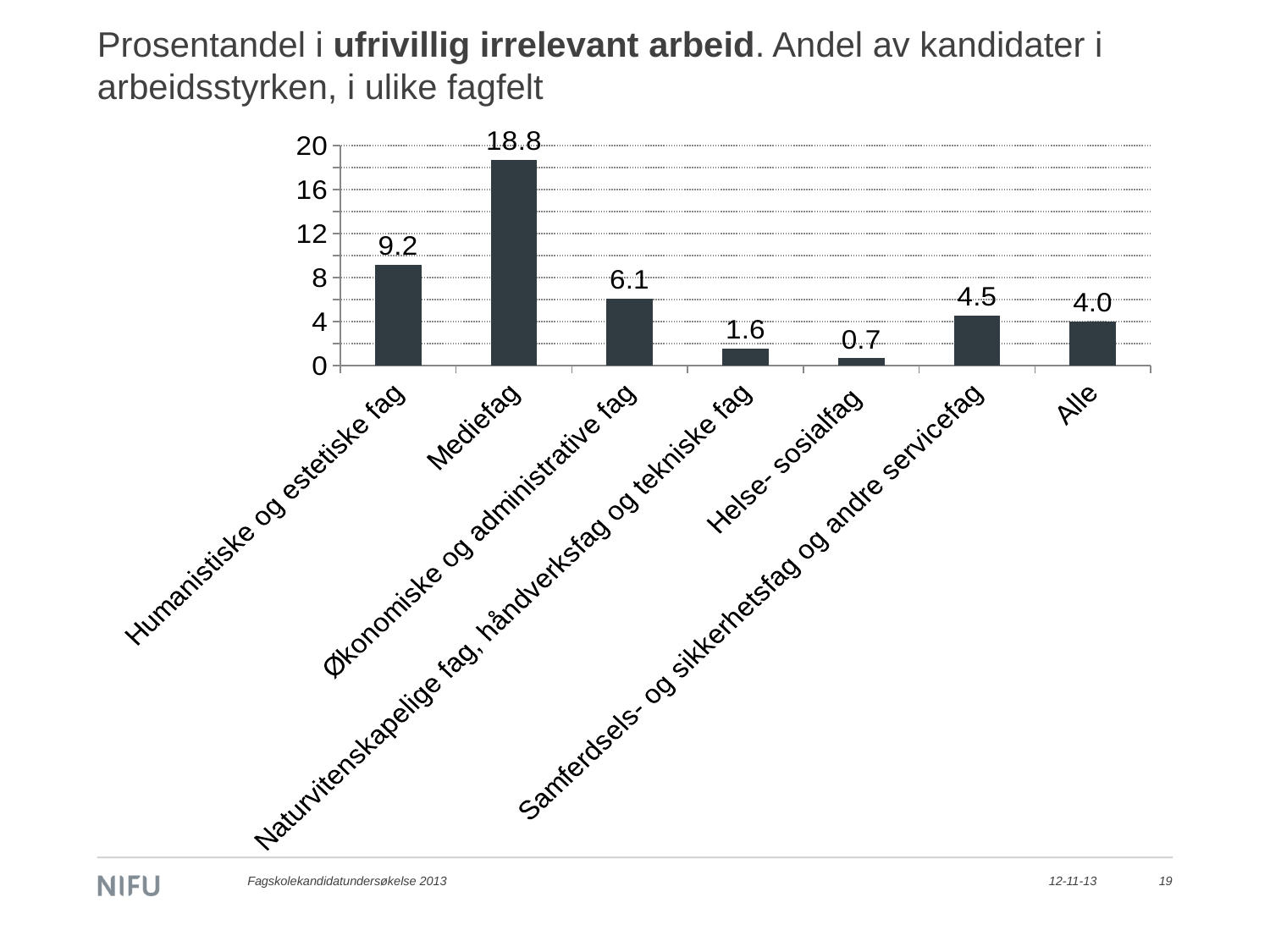
What is the value for Humanistiske og estetiske fag? 9.2 Which category has the lowest value? Helse- sosialfag What is the difference between the values for Samferdsels- og sikkerhetsfag og andre servicefag and Alle? 0.5 Which is larger, the value for Økonomiske og administrative fag or the value for Samferdsels- og sikkerhetsfag og andre servicefag? Økonomiske og administrative fag What is the value for Mediefag? 18.8 How many categories are shown on the x axis? 7 Which category has the highest value? Mediefag Is the value for Naturvitenskapelige fag, håndverksfag og tekniske fag greater or less than 4? less What kind of chart is shown on the slide? bar chart What is the difference between the values for Mediefag and Humanistiske og estetiske fag? 9.6 What is the value for Alle? 4.0 What is the value for Helse- sosialfag? 0.7